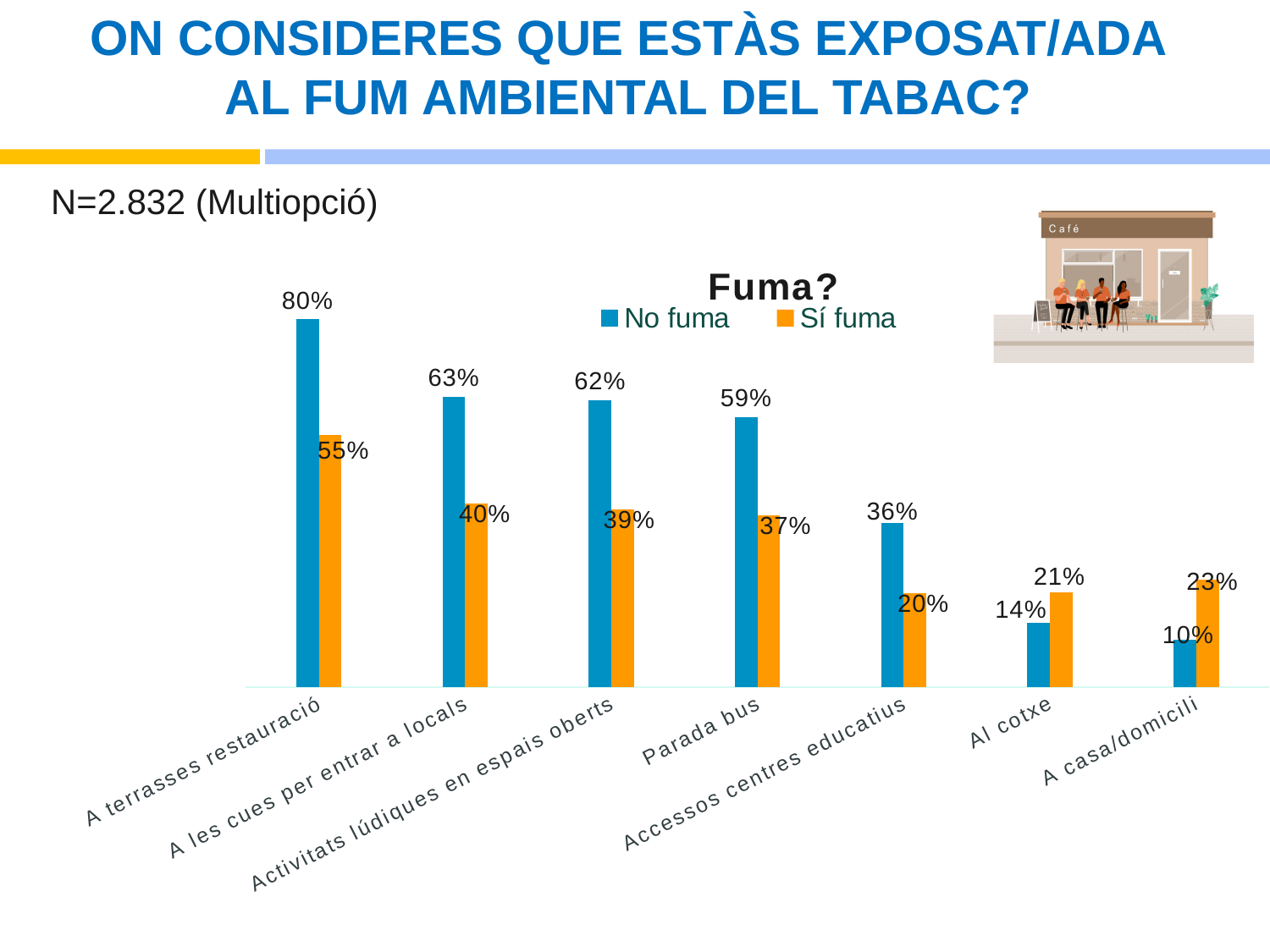
What is the 'Sí fuma' value for 'A casa/domicili'? 23% What is the 'Sí fuma' value for 'Parada bus'? 37% What is the difference between the 'No fuma' and 'Sí fuma' values for 'A les cues per entrar a locals'? 23% Which category has the highest 'No fuma' value? A terrasses restauració Which category has the lowest 'Sí fuma' value? Accessos centres educatius What is the 'No fuma' value for 'A terrasses restauració'? 80% How many categories are shown on the x axis? 7 How many series does the legend list? 2 Which category has the lowest 'No fuma' value? A casa/domicili What kind of chart is shown on the slide? Bar chart For 'Al cotxe', which is larger: 'No fuma' or 'Sí fuma'? Sí fuma What is the title of the chart's legend? Fuma?